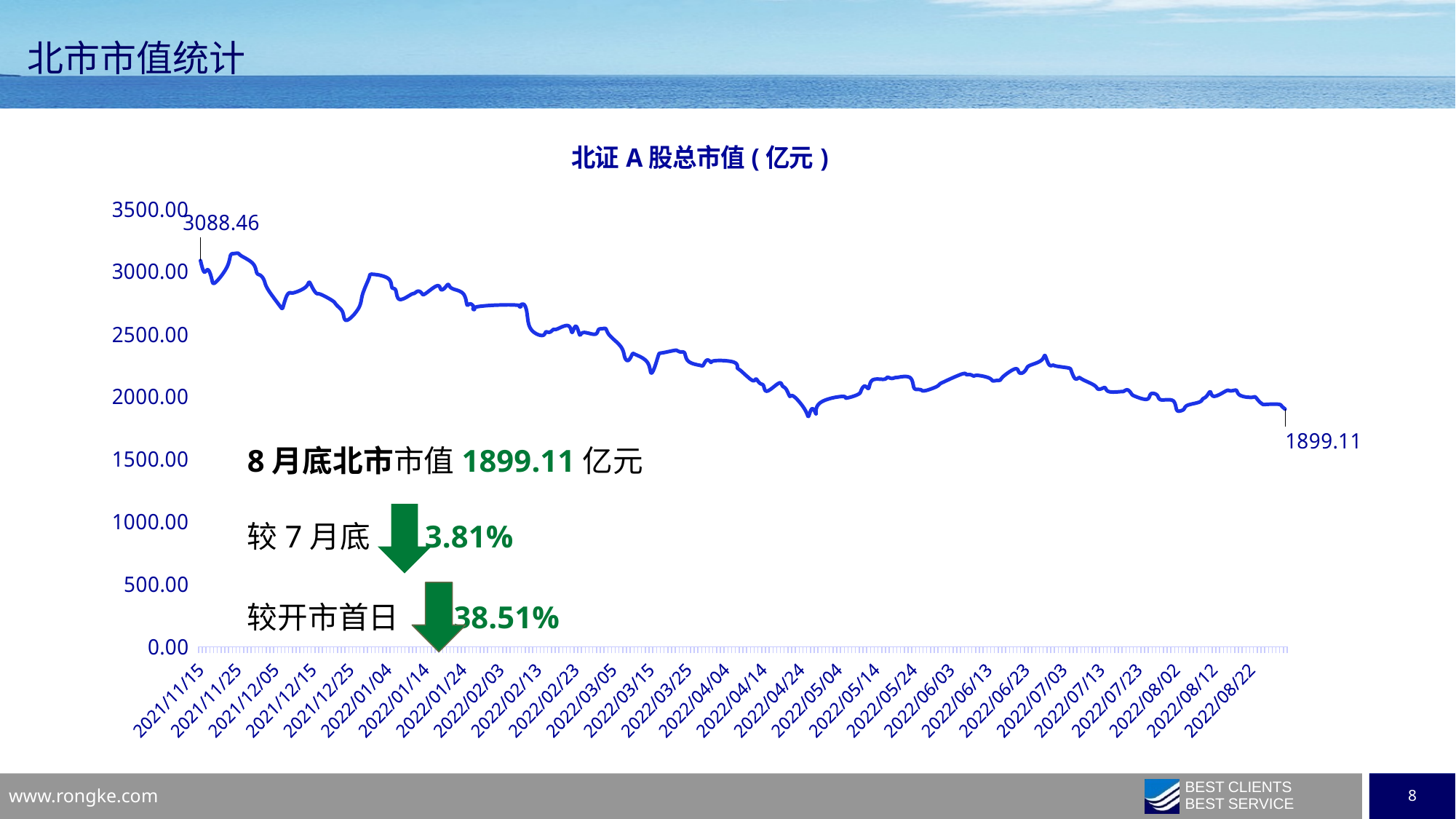
Is the value around 2022/04/24 greater or less than 2000? less How many data points on the line have printed value labels? 2 What is the difference between the first labelled value (3088.46) and the last labelled value (1899.11)? 1189.35 Overall, does the total market value rise or fall from left to right along the x axis? fall What is the value labelled at the start of the line (2021/11/15)? 3088.46 What is the title of the chart? 北证A股总市值(亿元) What is the highest value shown on the y axis? 3500.00 Is the value around 2022/01/04 greater or less than 2500? greater What kind of chart is shown on the slide? line chart Which is larger, the value at the start of the line or the value at the end of the line? the value at the start (3088.46) What is the value labelled at the end of the line (late August 2022)? 1899.11 Is the value around 2022/06/23 greater or less than 2000? greater